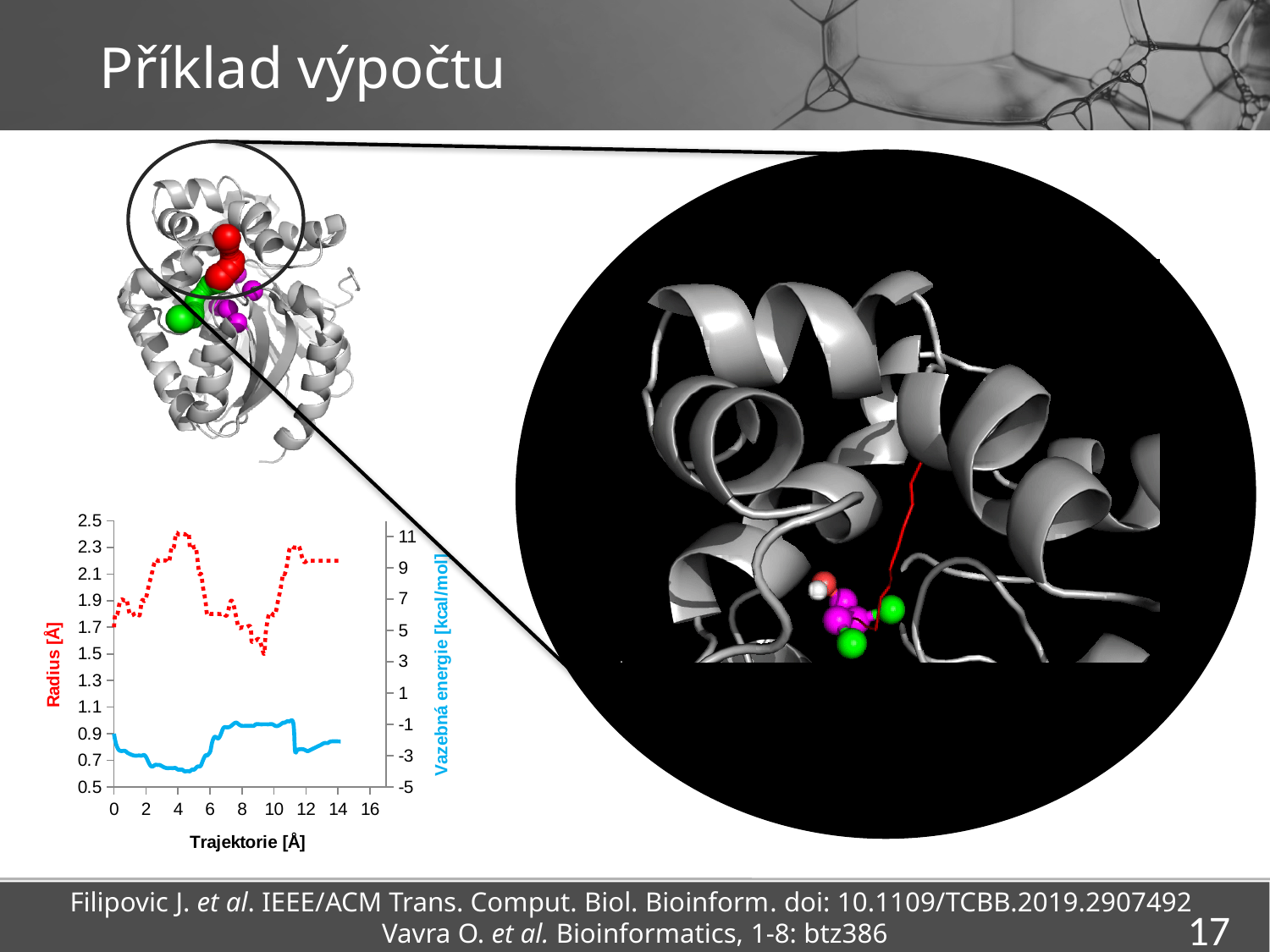
Is the Vazebná energie value at trajectory 8 greater or less than -3? greater How many data series are plotted in the chart? 2 What is the label of the right-hand y axis of the chart? Vazebná energie [kcal/mol] Is the Vazebná energie value at trajectory 4 greater or less than -1? less What is the label of the x axis of the chart? Trajektorie [Å] Between trajectory 0 and trajectory 4, does the Radius series rise or fall? rise Is the Radius value at trajectory 9 greater or less than 1.9? less What kind of chart is shown on the slide? line chart Between trajectory 4 and trajectory 9, does the Radius series rise or fall? fall Which is larger, the Radius value at trajectory 4 or at trajectory 9? trajectory 4